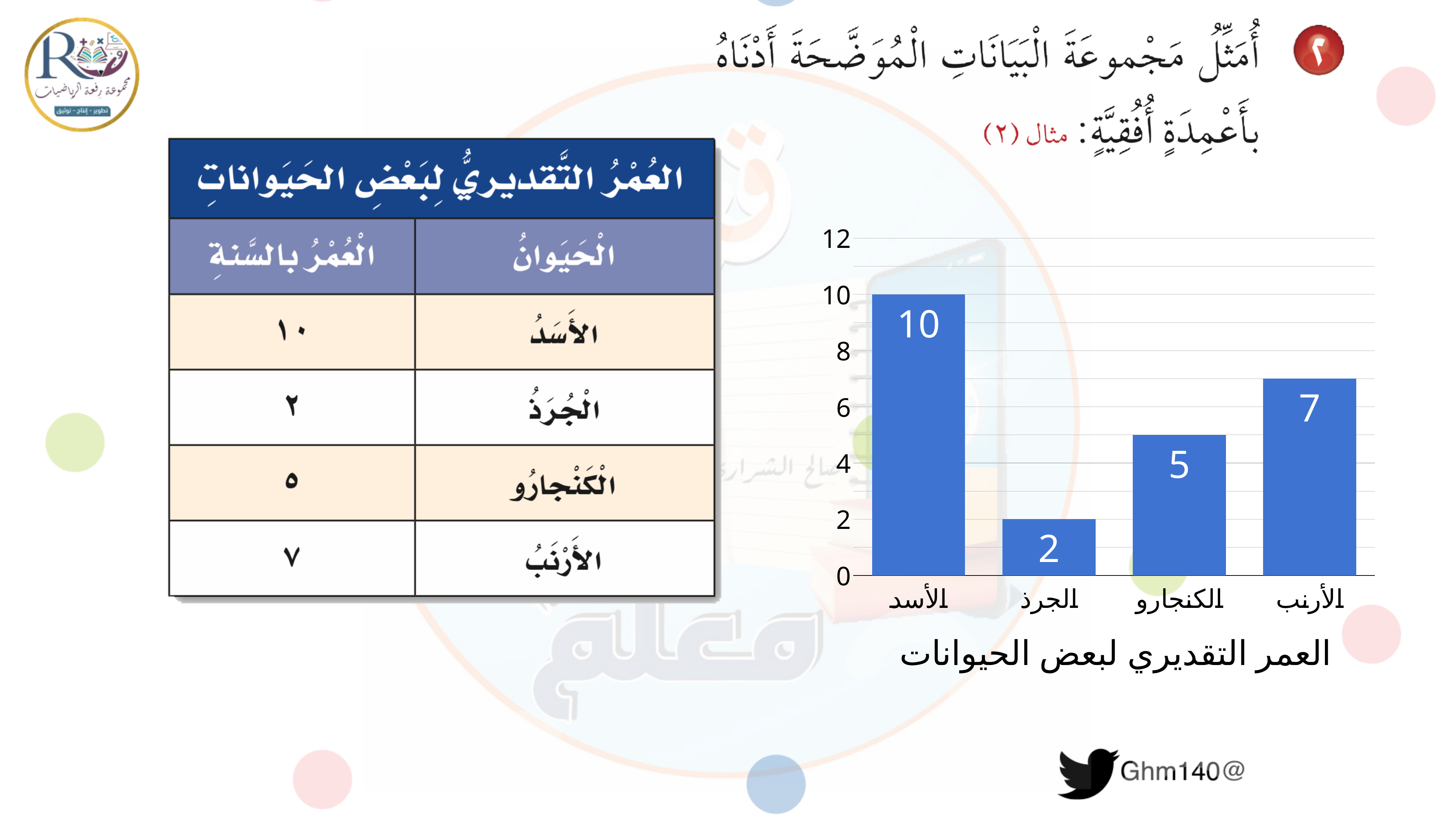
What is the value for الجرذ in the bar chart? 2 What is the title of the chart? العمر التقديري لبعض الحيوانات Which is larger, the value for الأرنب or the value for الكنجارو? الأرنب Which animal has the highest value in the bar chart? الأسد What kind of chart is shown on the slide? bar chart What is the value for الكنجارو in the bar chart? 5 How many categories are shown in the bar chart? 4 What is the difference between the values for الكنجارو and الجرذ? 3 What is the value for الأرنب in the bar chart? 7 What is the difference between the values for الأسد and الأرنب? 3 What is the value for الأسد in the bar chart? 10 Which animal has the lowest value in the bar chart? الجرذ